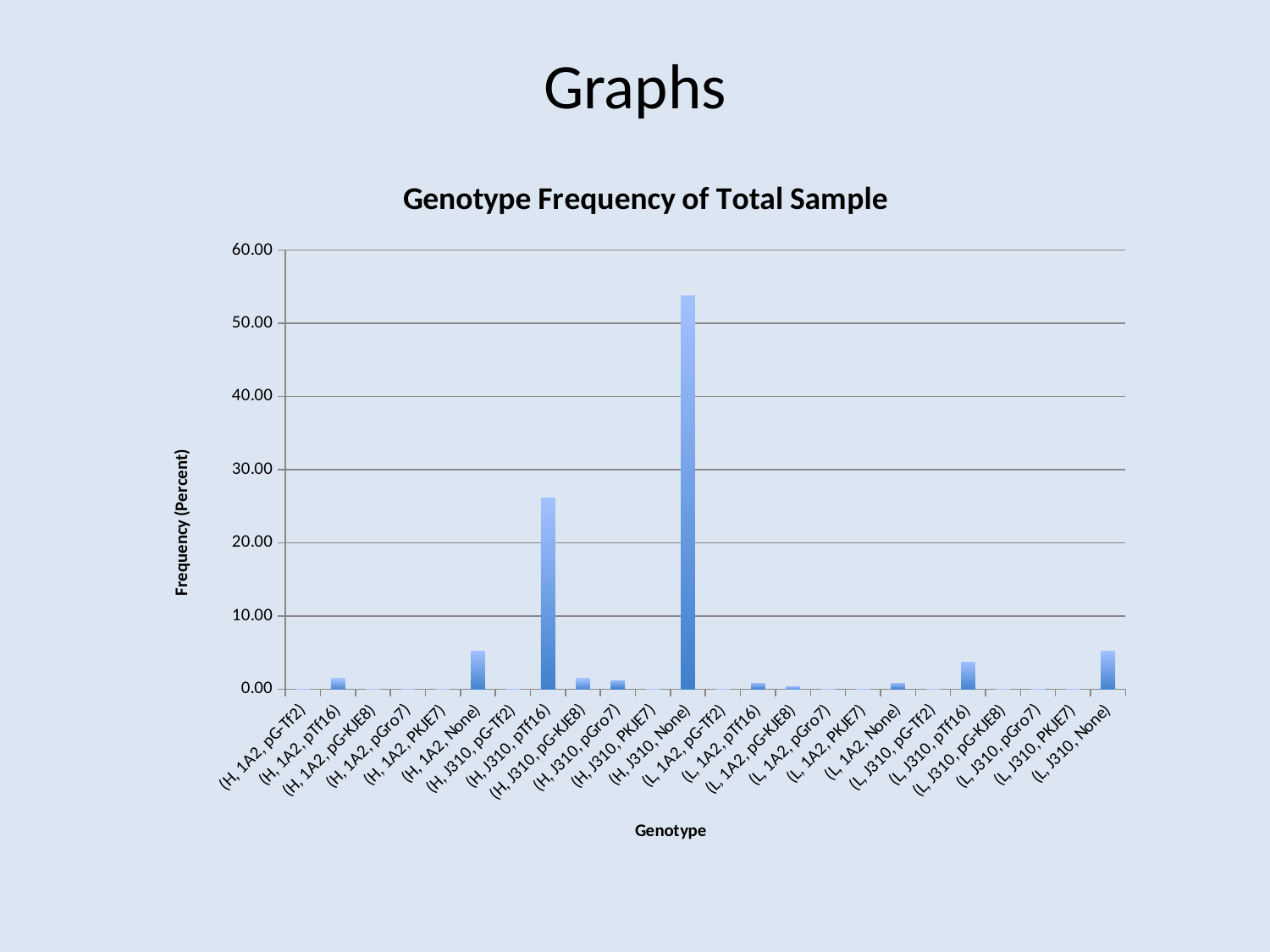
Is the value for (H, J310, pTf16) greater or less than 30? less Is the value for (L, J310, None) greater or less than 10? less What is the label of the vertical axis? Frequency (Percent) Which has a higher frequency, (H, J310, pTf16) or (L, J310, None)? (H, J310, pTf16) How many genotype categories are plotted on the x axis? 24 What type of chart is shown on the slide? bar chart Is the value for (H, J310, None) greater or less than 50? greater Which genotype has the highest frequency? (H, J310, None) What is the title of the chart? Genotype Frequency of Total Sample Which has a higher frequency, (H, J310, None) or (H, J310, pTf16)? (H, J310, None)